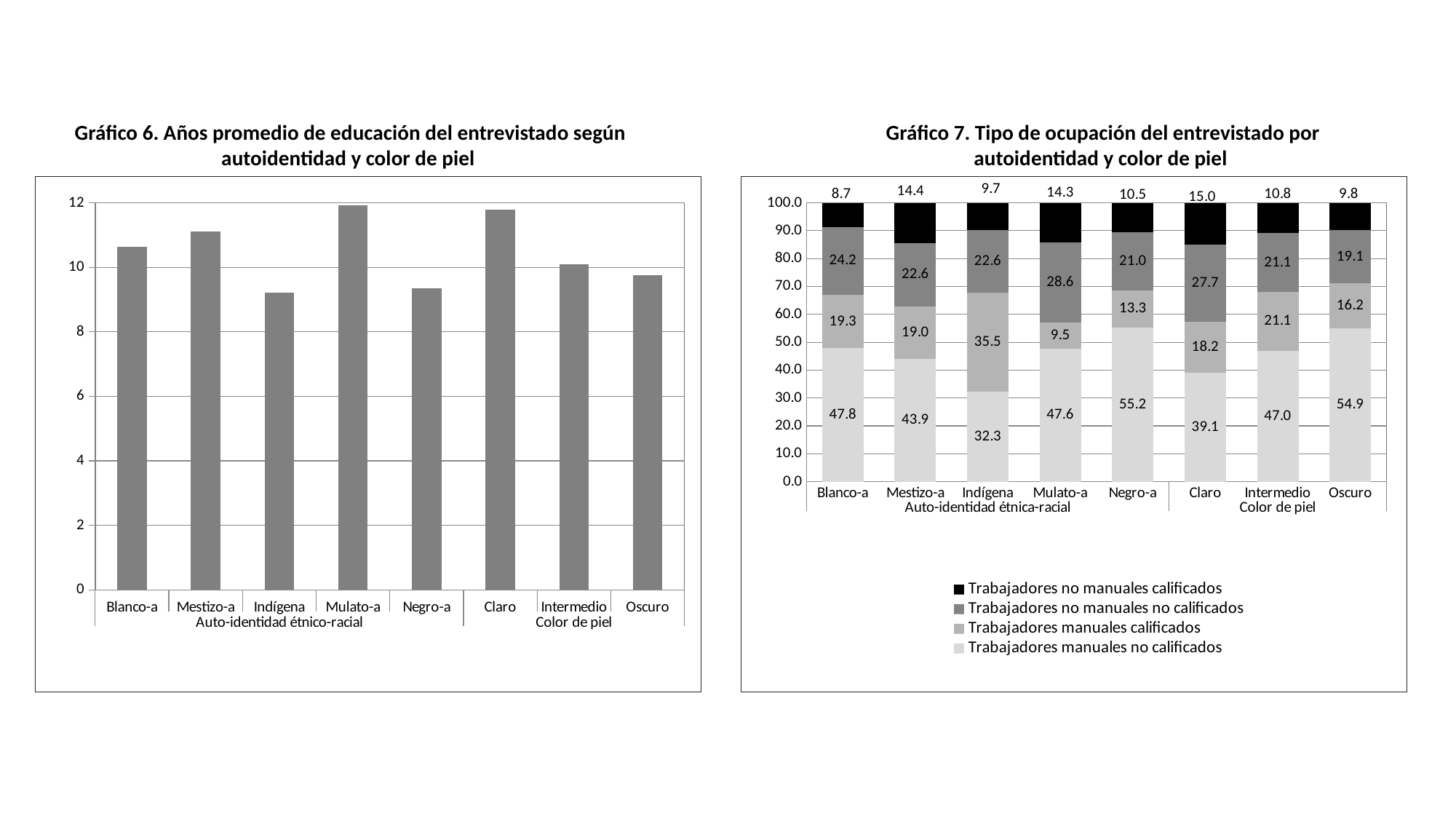
In Gráfico 7, which category has the lowest value for Trabajadores manuales calificados? Mulato-a In Gráfico 7, what is the value for Trabajadores manuales no calificados for Indígena? 32.3 In Gráfico 6, is the value for Mulato-a greater or less than 10? greater In Gráfico 6, is the value for Indígena greater or less than 10? less In Gráfico 7, what is the value for Trabajadores no manuales calificados for Claro? 15.0 In Gráfico 7, which category has the highest value for Trabajadores manuales no calificados? Negro-a In Gráfico 7, what is the difference between the Trabajadores manuales no calificados values for Blanco-a and Mestizo-a? 3.9 In Gráfico 6, is the value for Oscuro greater or less than 10? less In Gráfico 6, which is larger, the value for Mestizo-a or the value for Indígena? Mestizo-a What kind of chart is Gráfico 6 (the left chart)? Bar chart How many series does the legend of Gráfico 7 list? 4 In Gráfico 6, how many categories are shown on the x axis? 8